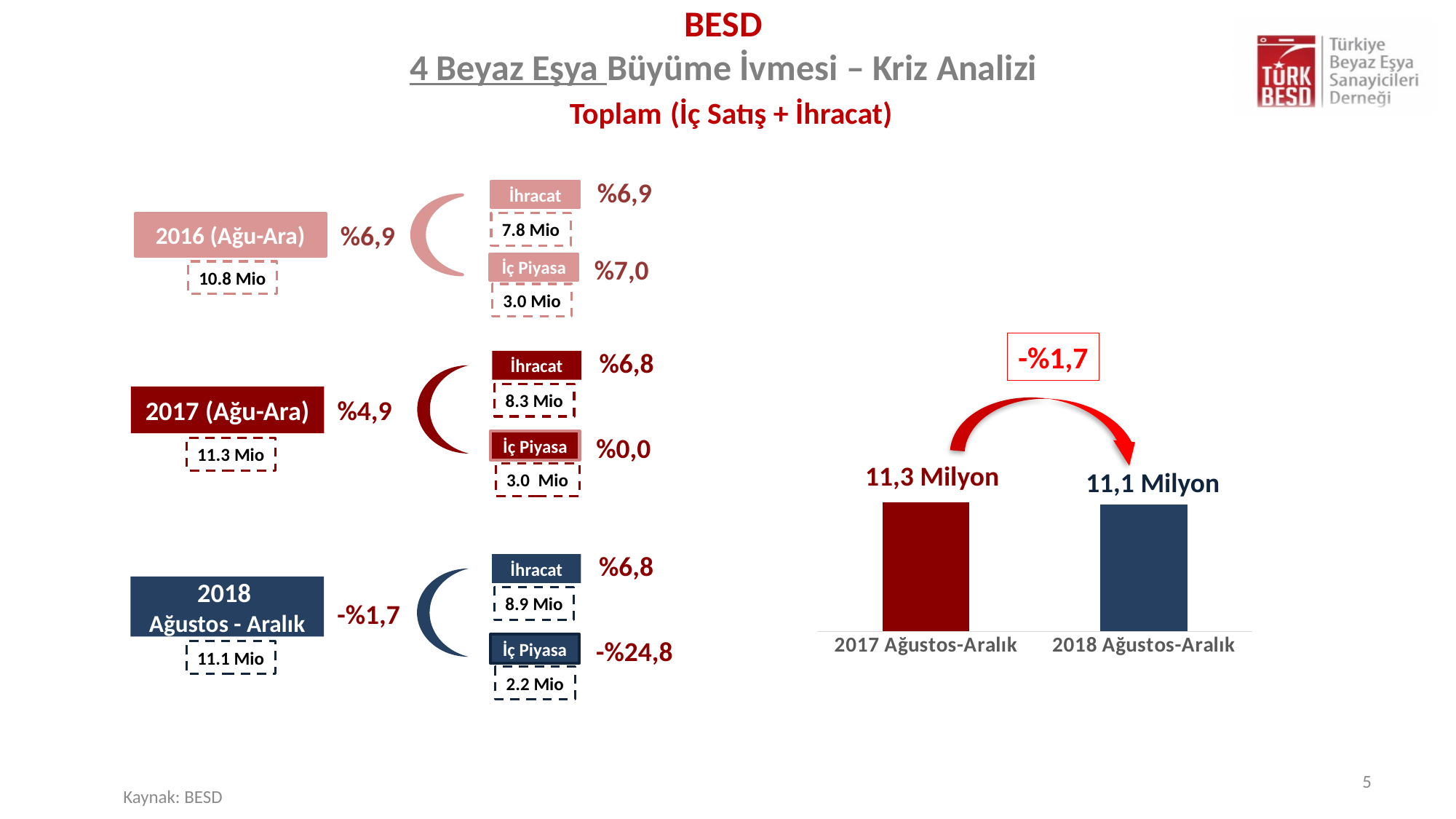
In the bar chart on the right, which category has the lowest value? 2018 Ağustos-Aralık In the bar chart on the right, which is larger: the value for 2017 Ağustos-Aralık or for 2018 Ağustos-Aralık? 2017 Ağustos-Aralık In the bar chart on the right, what colour is the bar for 2017 Ağustos-Aralık? dark red What percentage change is annotated above the bar chart on the right? -%1,7 In the bar chart on the right, what is the value for 2018 Ağustos-Aralık? 11,1 Milyon In the bar chart on the right, which category has the highest value? 2017 Ağustos-Aralık In the bar chart on the right, what is the value for 2017 Ağustos-Aralık? 11,3 Milyon How many bars are shown in the bar chart on the right? 2 What kind of chart is shown on the right side of the slide? bar chart In the bar chart on the right, what is the difference between the 2017 Ağustos-Aralık and 2018 Ağustos-Aralık values? 0,2 Milyon In the bar chart on the right, do the values rise or fall from 2017 Ağustos-Aralık to 2018 Ağustos-Aralık? fall